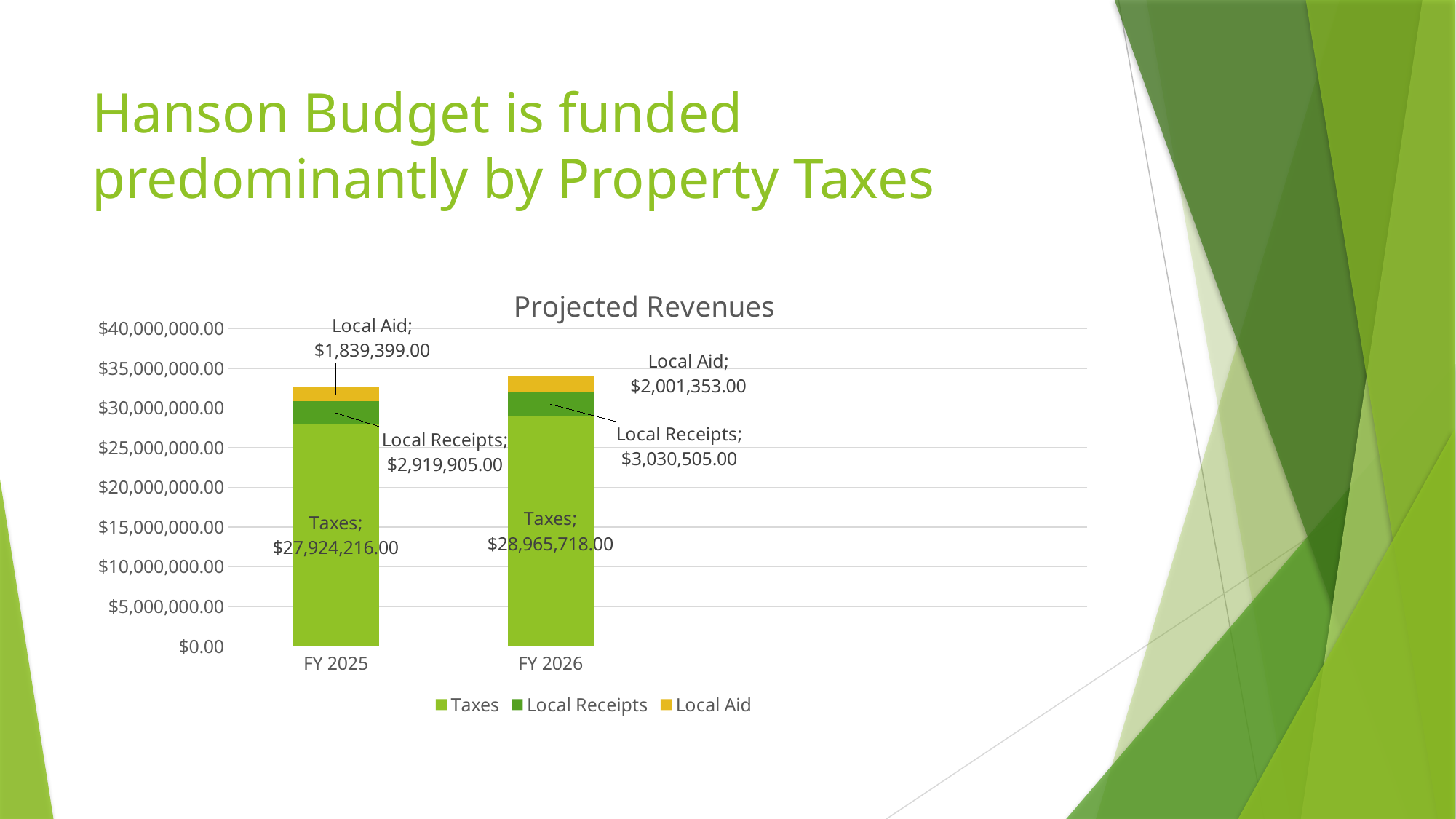
What is the value of Taxes for FY 2026? $28,965,718.00 Which series is the smallest component of the FY 2025 bar? Local Aid How many series does the legend list? 3 What type of chart is shown on the slide? Stacked bar chart What is the value of Local Aid for FY 2026? $2,001,353.00 What is the difference between Taxes in FY 2026 and Taxes in FY 2025? $1,041,502.00 What is the total of the FY 2026 stacked bar? $33,997,576.00 Which series is the largest component of the FY 2026 bar? Taxes Which is larger: Local Receipts in FY 2025 or Local Receipts in FY 2026? FY 2026 What is the total of the FY 2025 stacked bar? $32,683,520.00 What is the value of Local Receipts for FY 2025? $2,919,905.00 What is the value of Taxes for FY 2025? $27,924,216.00